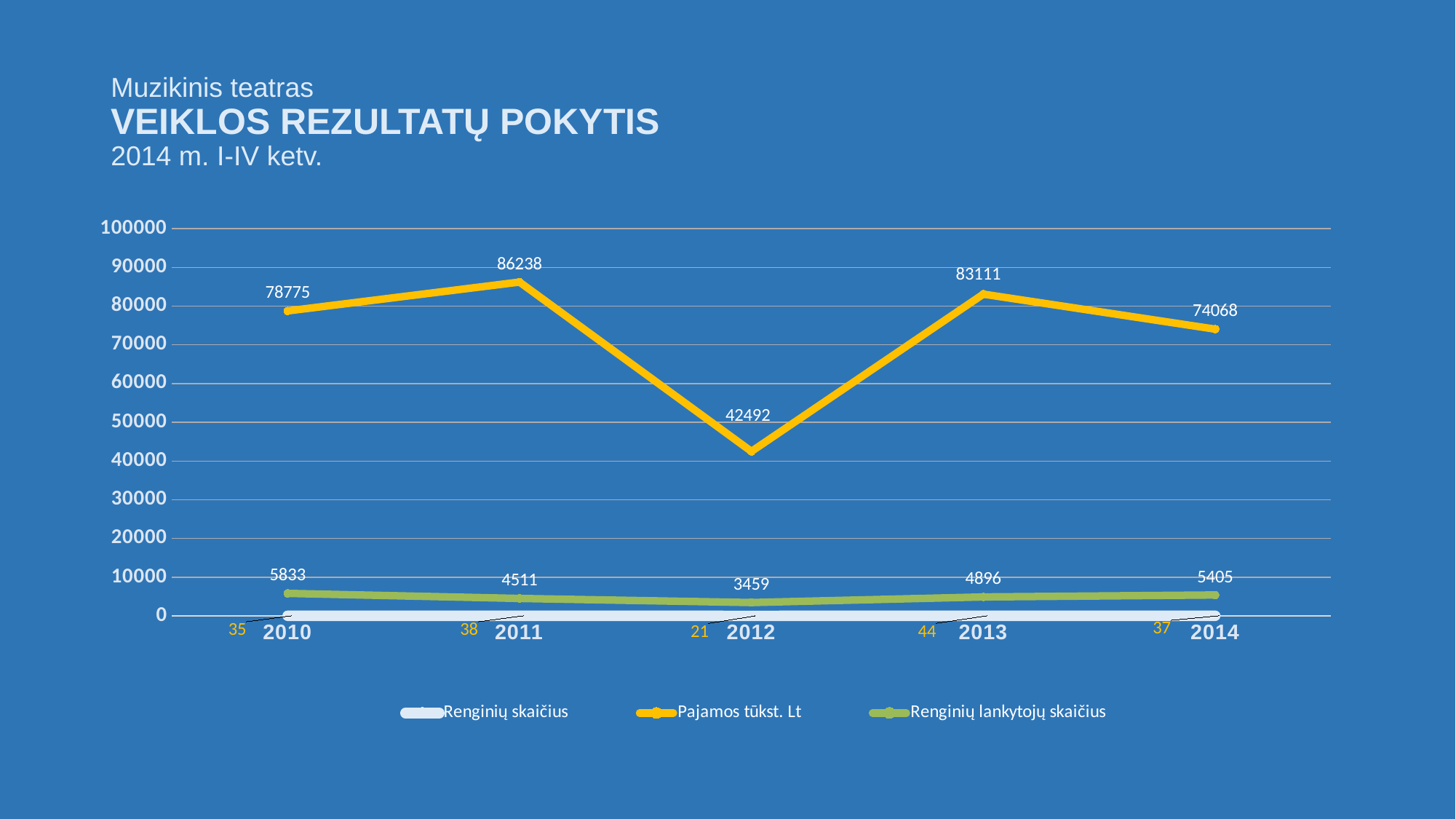
Which is larger: Renginių lankytojų skaičius in 2011 or in 2014? 2014 In which year is Pajamos tūkst. Lt highest? 2011 What type of chart is shown on the slide? line chart How many years are shown on the x axis? 5 In which year is Renginių lankytojų skaičius lowest? 2012 What is the difference between Pajamos tūkst. Lt in 2013 and in 2014? 9043 How many series does the legend list? 3 Does Pajamos tūkst. Lt rise or fall from 2012 to 2013? rise What is the value of Renginių lankytojų skaičius in 2010? 5833 What is the value of Renginių skaičius in 2013? 44 Is the value of Pajamos tūkst. Lt in 2010 greater or less than 70000? greater What is the value of Pajamos tūkst. Lt in 2012? 42492